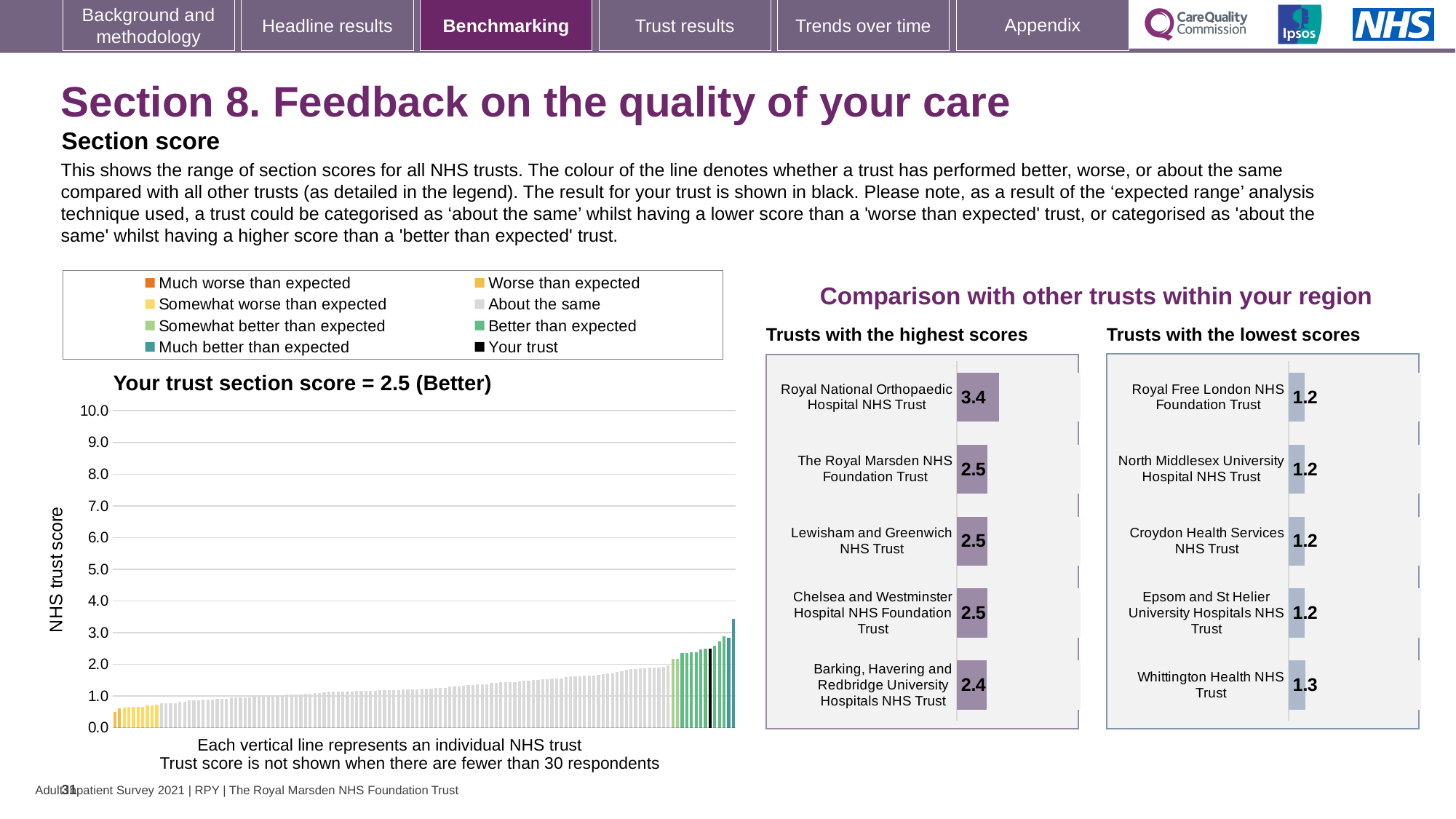
In the 'Trusts with the highest scores' chart, what is the difference between the scores of Royal National Orthopaedic Hospital NHS Trust and Barking, Havering and Redbridge University Hospitals NHS Trust? 1.0 In the 'Your trust section score' chart, what is the section score for your trust? 2.5 In the 'Your trust section score' chart, is the value of the tallest bar greater or less than 4.0? less In the 'Trusts with the highest scores' chart, what is the score for Royal National Orthopaedic Hospital NHS Trust? 3.4 In the 'Trusts with the highest scores' chart, which trust has the highest score? Royal National Orthopaedic Hospital NHS Trust How many trusts are shown in the 'Trusts with the highest scores' chart? 5 In the 'Your trust section score' chart, do the bars rise or fall from left to right? rise In the 'Your trust section score' chart, what colour is the bar for your trust? black How many entries does the legend above the 'Your trust section score' chart list? 8 In the 'Trusts with the lowest scores' chart, which is larger: the score for Whittington Health NHS Trust or the score for Croydon Health Services NHS Trust? Whittington Health NHS Trust What kind of chart is the 'Your trust section score' chart? bar chart In the 'Trusts with the lowest scores' chart, what is the score for Whittington Health NHS Trust? 1.3